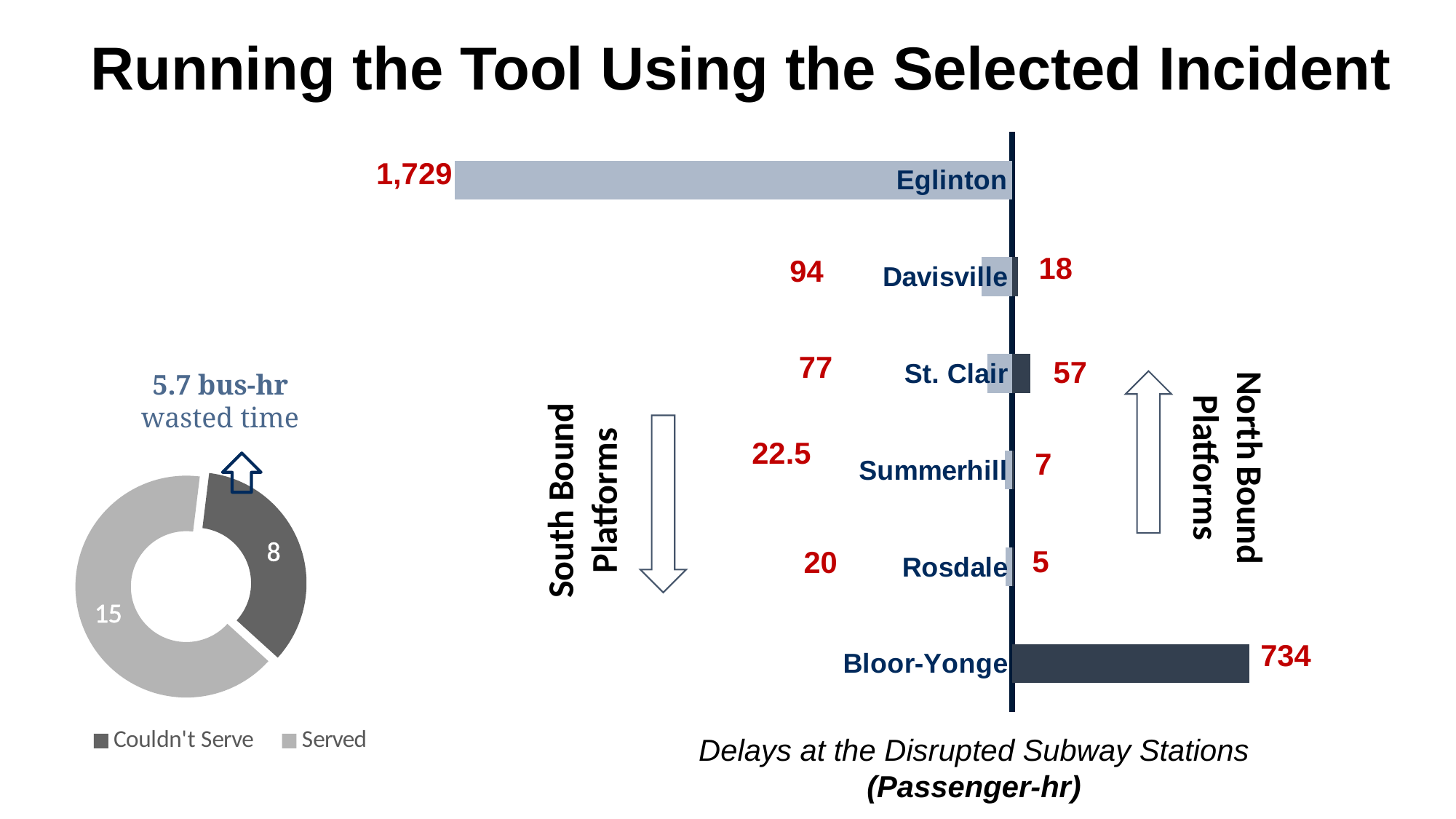
What kind of chart is the 'Delays at the Disrupted Subway Stations' chart? Bar chart In the doughnut chart on the left, what is the value for 'Couldn't Serve'? 8 In the 'Delays at the Disrupted Subway Stations' chart, what is the North Bound delay value for St. Clair? 57 In the doughnut chart on the left, what is the total of the 'Couldn't Serve' and 'Served' values? 23 How many stations are listed in the 'Delays at the Disrupted Subway Stations' chart? 6 In the 'Delays at the Disrupted Subway Stations' chart, which station has the lowest North Bound delay? Rosdale In the 'Delays at the Disrupted Subway Stations' chart, what is the South Bound delay value for Eglinton? 1,729 In the 'Delays at the Disrupted Subway Stations' chart, which station has the highest South Bound delay? Eglinton In the 'Delays at the Disrupted Subway Stations' chart, what is the difference between the South Bound and North Bound delays at Davisville? 76 In the 'Delays at the Disrupted Subway Stations' chart, what is the North Bound delay value for Bloor-Yonge? 734 In the 'Delays at the Disrupted Subway Stations' chart, what is the South Bound delay value for Summerhill? 22.5 In the 'Delays at the Disrupted Subway Stations' chart, which is larger: the South Bound delay at Rosdale or the North Bound delay at Rosdale? South Bound (20)